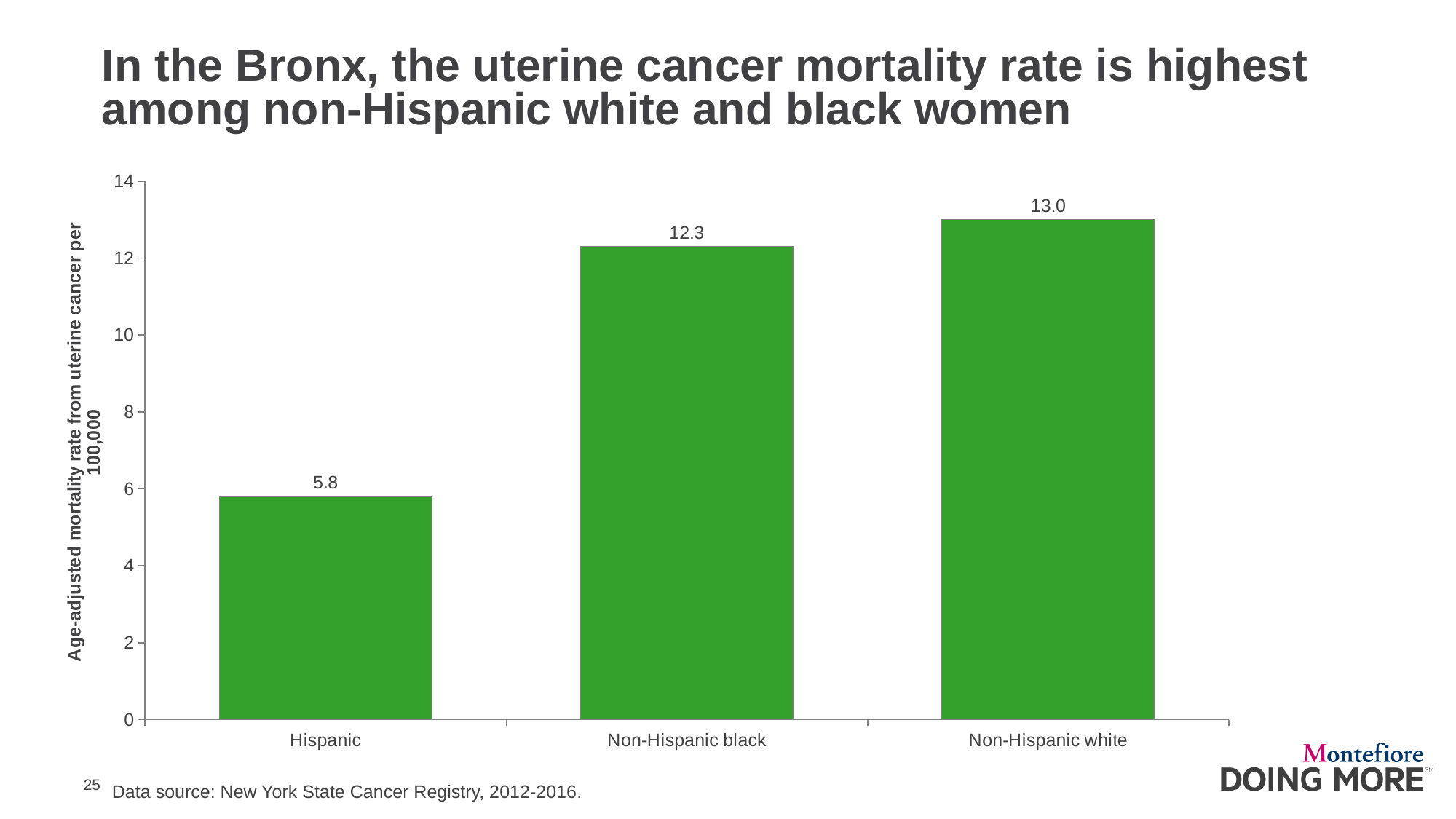
What is the age-adjusted uterine cancer mortality rate for Hispanic women? 5.8 What is the label of the vertical axis? Age-adjusted mortality rate from uterine cancer per 100,000 What is the age-adjusted uterine cancer mortality rate for Non-Hispanic white women? 13.0 Which is larger, the mortality rate for Non-Hispanic black women or for Hispanic women? Non-Hispanic black What is the difference between the mortality rates for Non-Hispanic white and Hispanic women? 7.2 Which group has the lowest uterine cancer mortality rate? Hispanic What is the difference between the mortality rates for Non-Hispanic white and Non-Hispanic black women? 0.7 What kind of chart is shown on the slide? Bar chart Is the value for Hispanic women greater or less than 6? less How many groups are shown on the x axis? 3 What is the age-adjusted uterine cancer mortality rate for Non-Hispanic black women? 12.3 Which group has the highest uterine cancer mortality rate? Non-Hispanic white